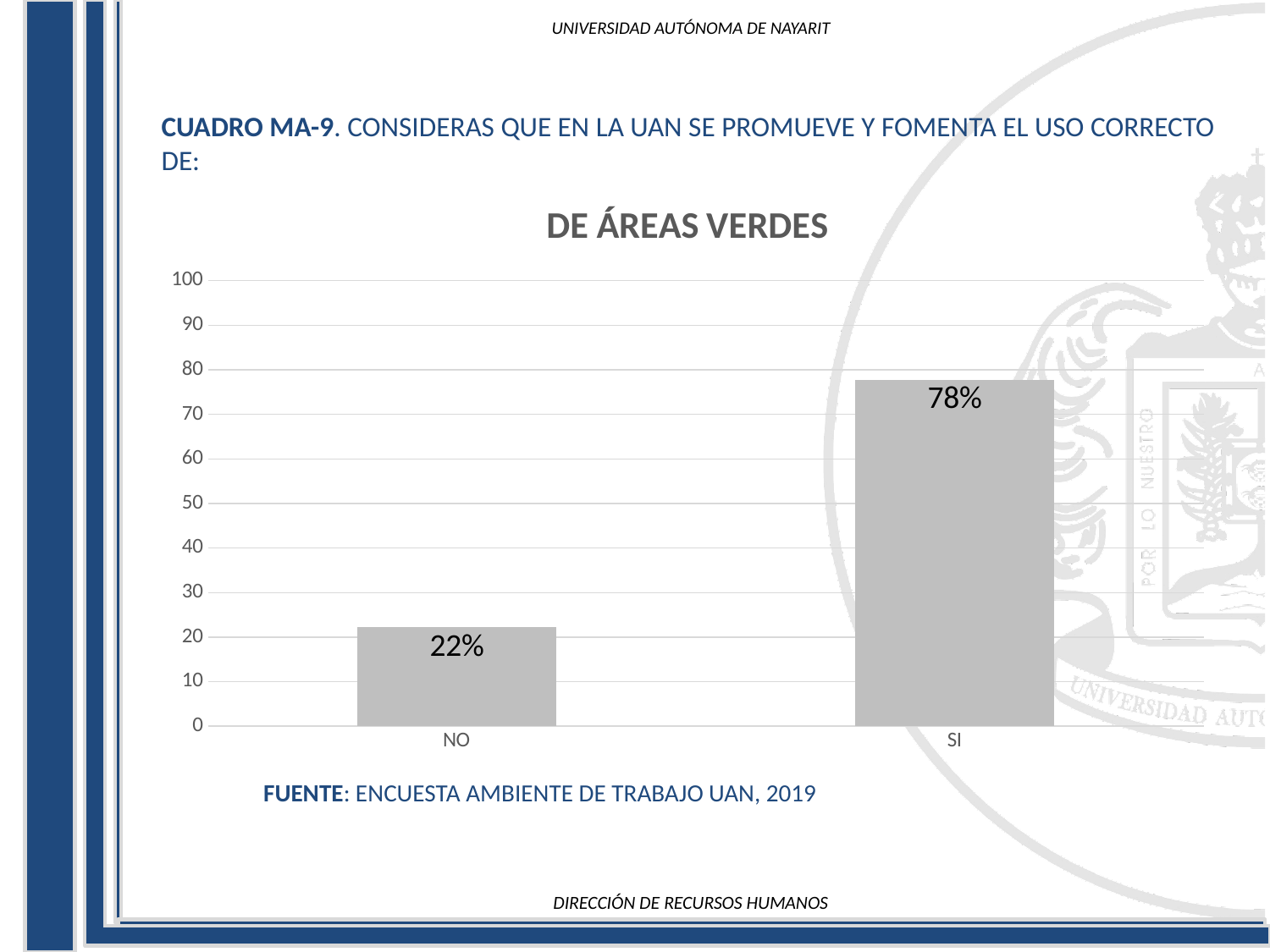
Which is larger, the value for NO or the value for SI? SI What is the highest value shown on the y axis? 100 Is the value for NO greater or less than 30? less Which category has the highest value? SI What is the value for SI? 78% Which category has the lowest value? NO What is the value for NO? 22% How many categories are shown on the x axis? 2 What kind of chart is shown? bar chart What is the title of the chart? DE ÁREAS VERDES What is the difference between the values for SI and NO? 56% Is the value for SI greater or less than 70? greater